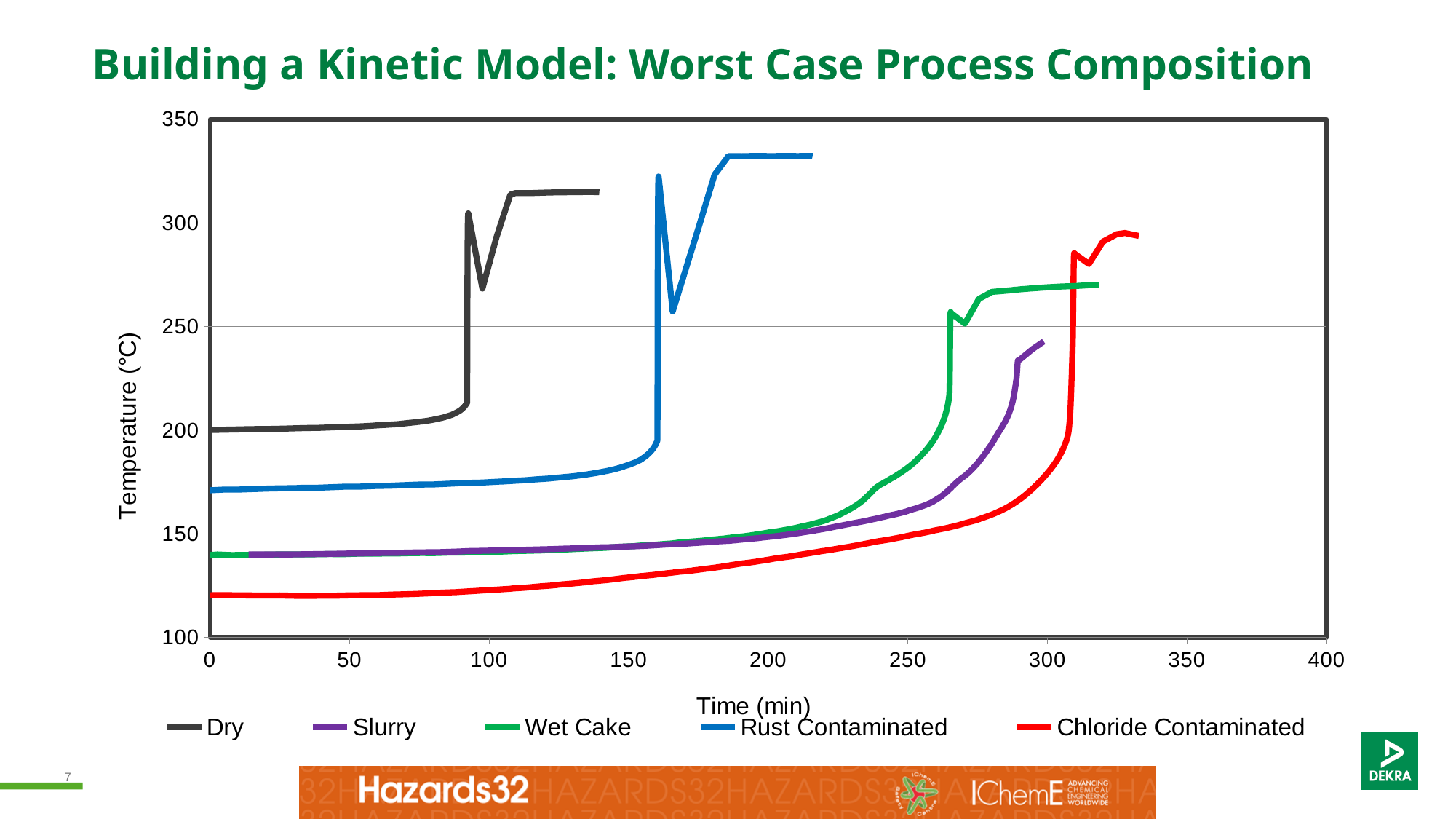
Is the plateau temperature reached by the Rust Contaminated series greater or less than 300? greater Is the starting temperature of the Chloride Contaminated series at time 0 greater or less than 150? less What is the label of the x axis? Time (min) Which series has the lowest starting temperature at time 0? Chloride Contaminated Is the plateau temperature of the Wet Cake series greater or less than 250? greater Does the temperature of the Chloride Contaminated series rise or fall as time increases? Rise Which series reaches a higher peak temperature, Dry or Wet Cake? Dry What is the label of the y axis? Temperature (°C) How many series does the legend list? 5 Which series reaches the highest temperature on the chart? Rust Contaminated What kind of chart is shown on the slide? Line chart